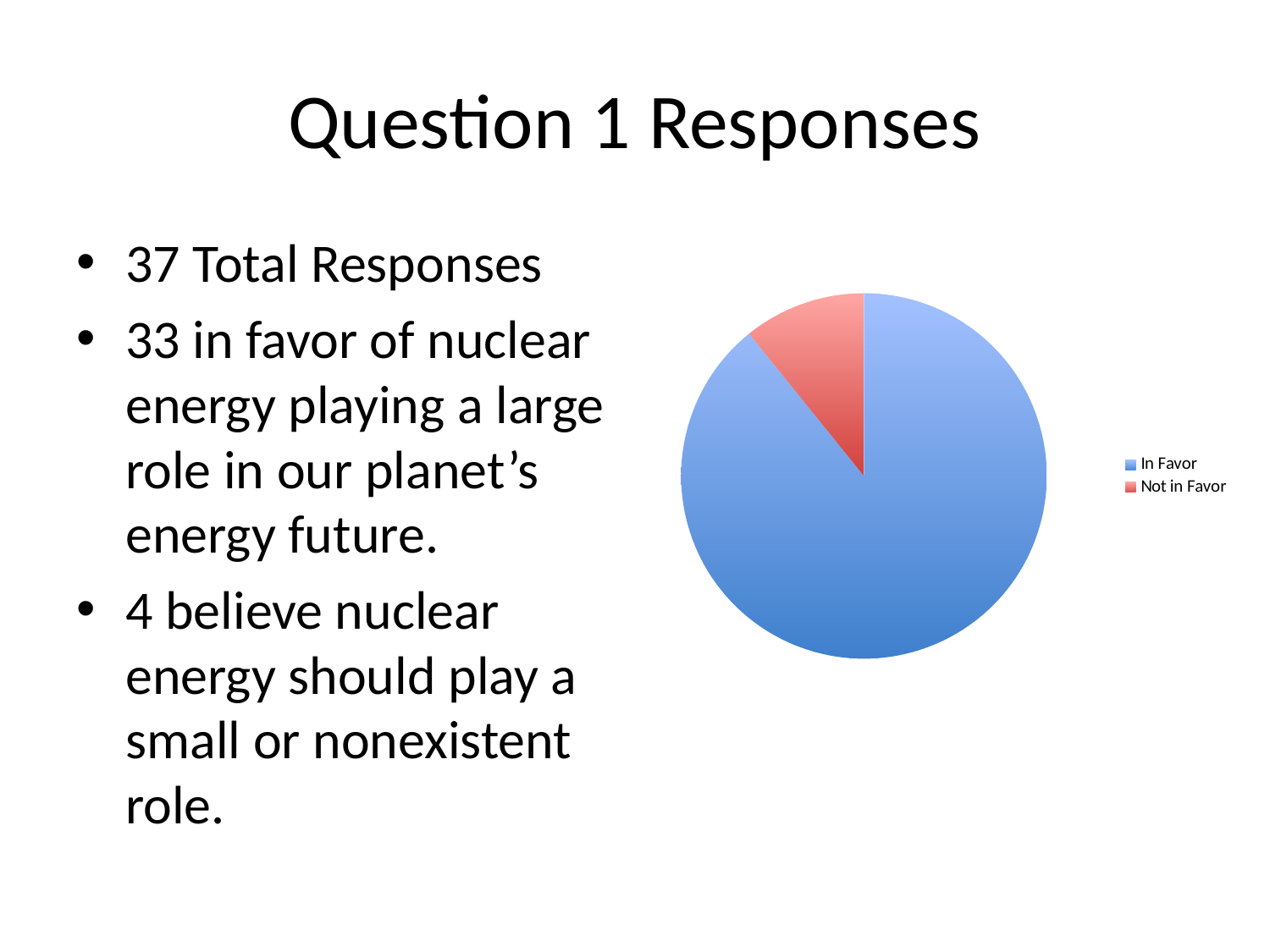
Which slice of the pie chart is the smallest? Not in Favor How many entries does the legend of the pie chart list? 2 According to the slide, how many responses were In Favor? 33 Which is larger in the pie chart, In Favor or Not in Favor? In Favor What colour is the In Favor slice of the pie chart? blue According to the slide, what is the total number of responses represented by the pie chart? 37 What is the difference between the number of In Favor responses and Not in Favor responses? 29 Which slice of the pie chart is the largest? In Favor How many slices does the pie chart have? 2 According to the slide, how many responses were Not in Favor? 4 What colour is the Not in Favor slice of the pie chart? red What kind of chart is shown on the slide? pie chart